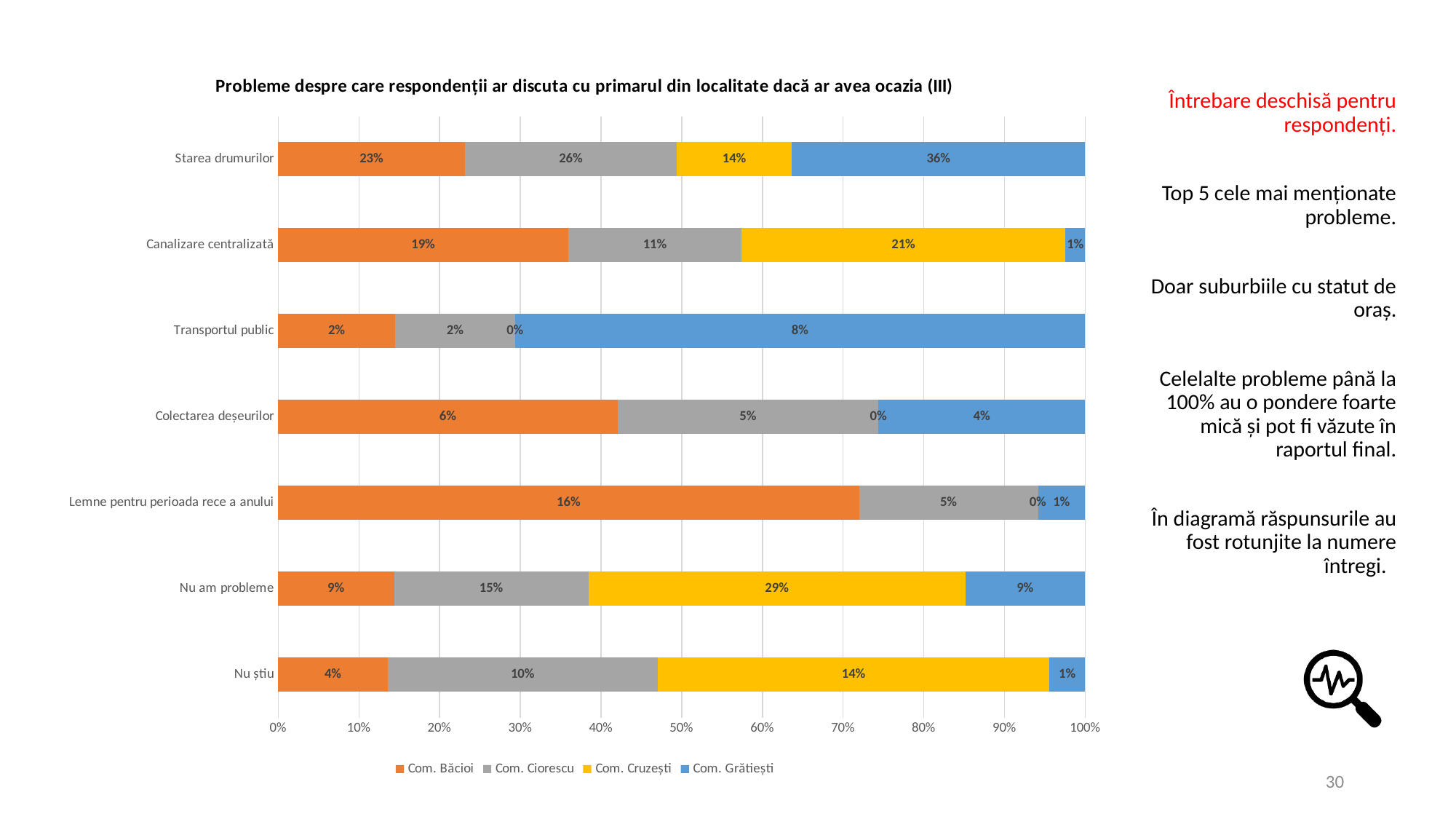
In the 'Nu știu' bar, which is larger: the value for Com. Ciorescu or the value for Com. Cruzești? Com. Cruzești How many problem categories are listed on the vertical axis of the chart? 7 Which series has the highest labelled value in the 'Starea drumurilor' bar? Com. Grătiești Which series has the lowest labelled value in the 'Canalizare centralizată' bar? Com. Grătiești Which colour represents Com. Cruzești in the chart legend? Yellow What value is labelled for Com. Cruzești in the 'Nu am probleme' bar? 29% What percentage is shown for Com. Grătiești in the 'Starea drumurilor' bar? 36% What percentage is shown for Com. Băcioi in the 'Lemne pentru perioada rece a anului' bar? 16% How many series does the chart legend list? 4 What value is labelled for Com. Ciorescu in the 'Canalizare centralizată' bar? 11% What is the difference between the Com. Cruzești and Com. Băcioi values in the 'Nu am probleme' bar? 20% What type of chart is shown on the slide? Stacked bar chart